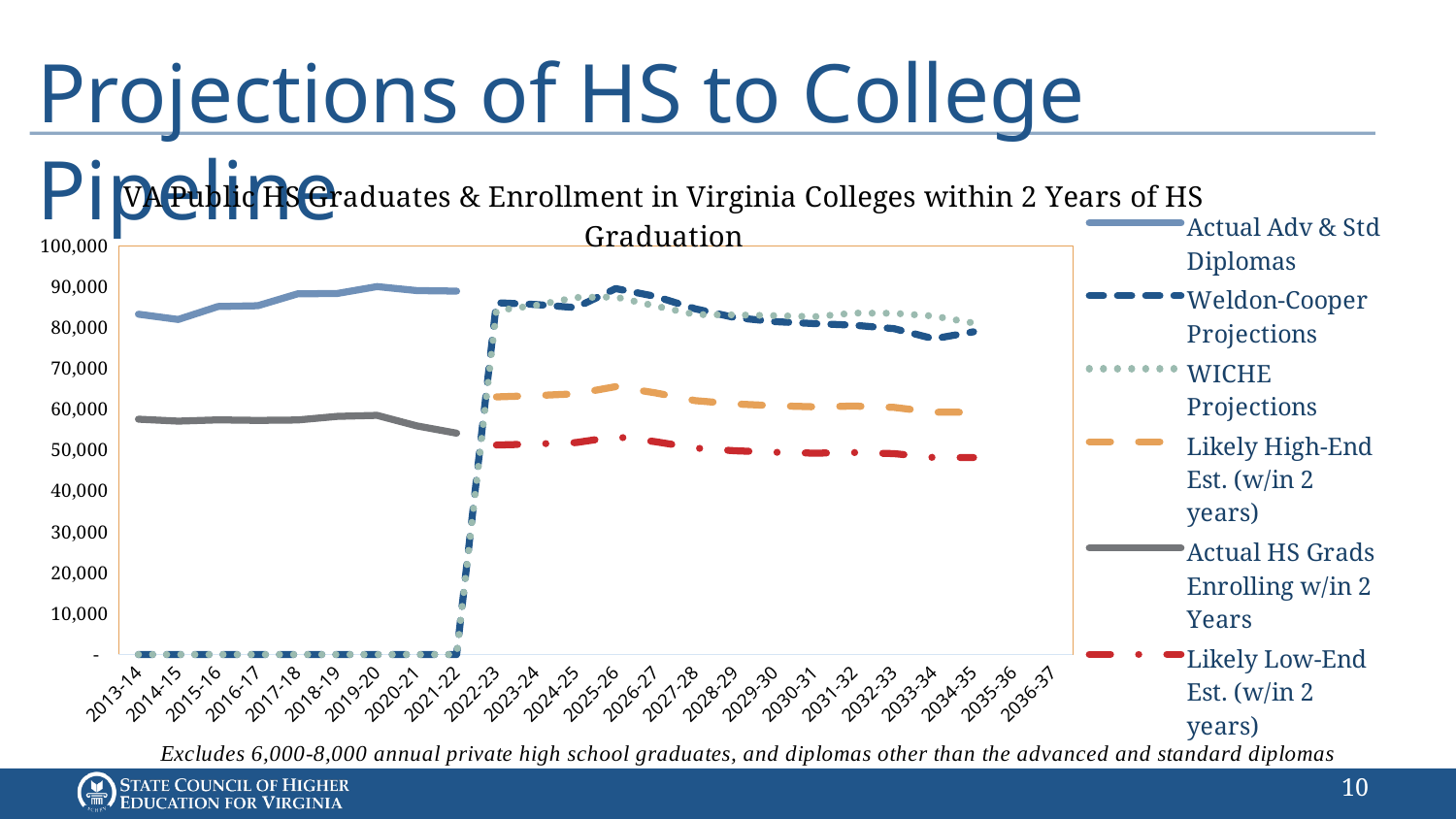
Does the Likely High-End Est. (w/in 2 years) line rise or fall from 2025-26 to 2034-35? fall Is the value for Actual Adv & Std Diplomas in 2013-14 greater or less than 80,000? greater How many series does the legend list? 6 Which legend entry is drawn as a solid grey line? Actual HS Grads Enrolling w/in 2 Years Is the value for Likely High-End Est. (w/in 2 years) in 2025-26 greater or less than 60,000? greater What kind of chart is shown on the slide? line chart Does the Actual HS Grads Enrolling w/in 2 Years line rise or fall from 2019-20 to 2021-22? fall In 2025-26, which is larger: Likely High-End Est. (w/in 2 years) or Likely Low-End Est. (w/in 2 years)? Likely High-End Est. (w/in 2 years) How many school years are shown along the x axis? 24 Is the value for Actual HS Grads Enrolling w/in 2 Years in 2013-14 greater or less than 50,000? greater What is the title of the chart? VA Public HS Graduates & Enrollment in Virginia Colleges within 2 Years of HS Graduation